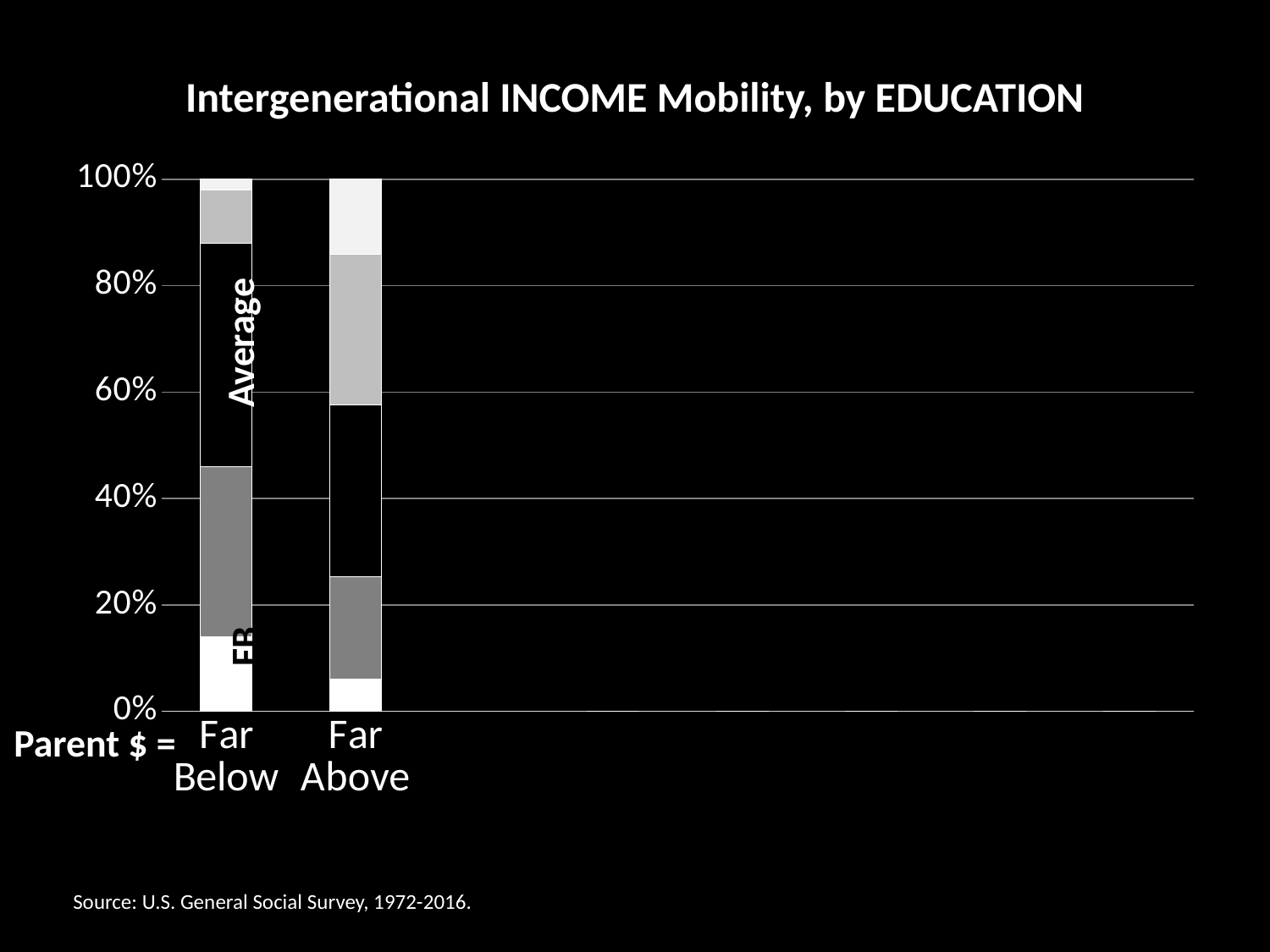
In the Far Above bar, is the top of the bottom white segment greater or less than 20%? less Which bar has the larger light gray segment, Far Below or Far Above? Far Above In the Far Above bar, is the top of the black segment greater or less than 40%? greater Which bar has the larger black 'Average' segment, Far Below or Far Above? Far Below What is the title of the chart? Intergenerational INCOME Mobility, by EDUCATION What are the two category labels on the x axis? Far Below, Far Above What value does the top of each stacked bar reach on the y axis? 100% In the Far Above bar, is the top of the light gray segment greater or less than 80%? greater What kind of chart is shown on the slide? stacked bar chart How many categories (bars) are plotted on the x axis? 2